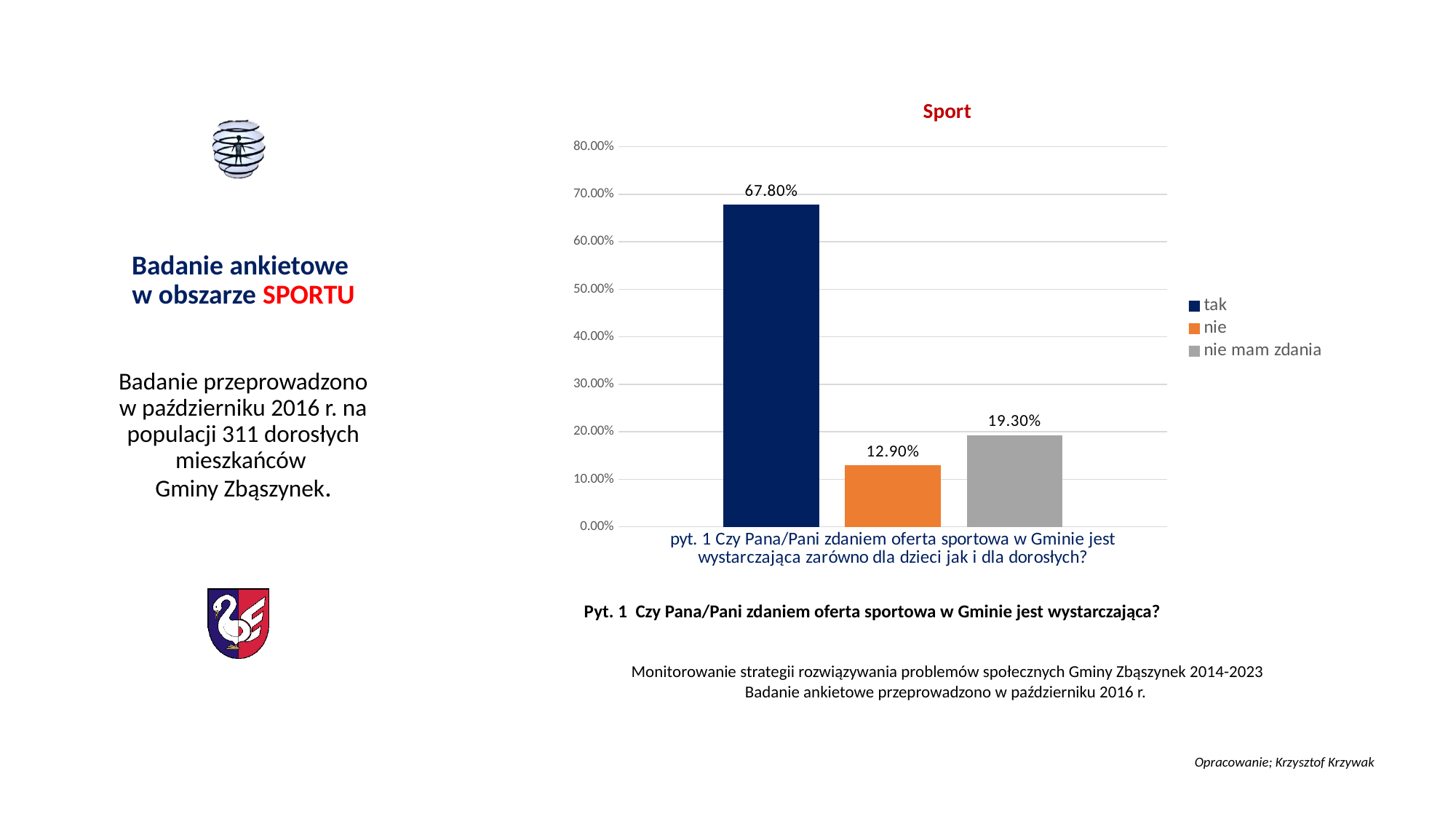
What is the value for "nie" in the Sport chart? 12.90% How many series does the legend of the Sport chart list? 3 What is the difference between the values for "tak" and "nie" in the Sport chart? 54.90% What is the title of the chart on the slide? Sport Which series has the lowest value in the Sport chart? nie What kind of chart is the Sport chart? bar chart Which series has the highest value in the Sport chart? tak What is the difference between the values for "nie mam zdania" and "nie" in the Sport chart? 6.40% What is the value for "nie mam zdania" in the Sport chart? 19.30% Which is larger in the Sport chart, the value for "nie" or the value for "nie mam zdania"? nie mam zdania Is the value for "tak" in the Sport chart greater or less than 60.00%? greater What is the value for "tak" in the Sport chart? 67.80%